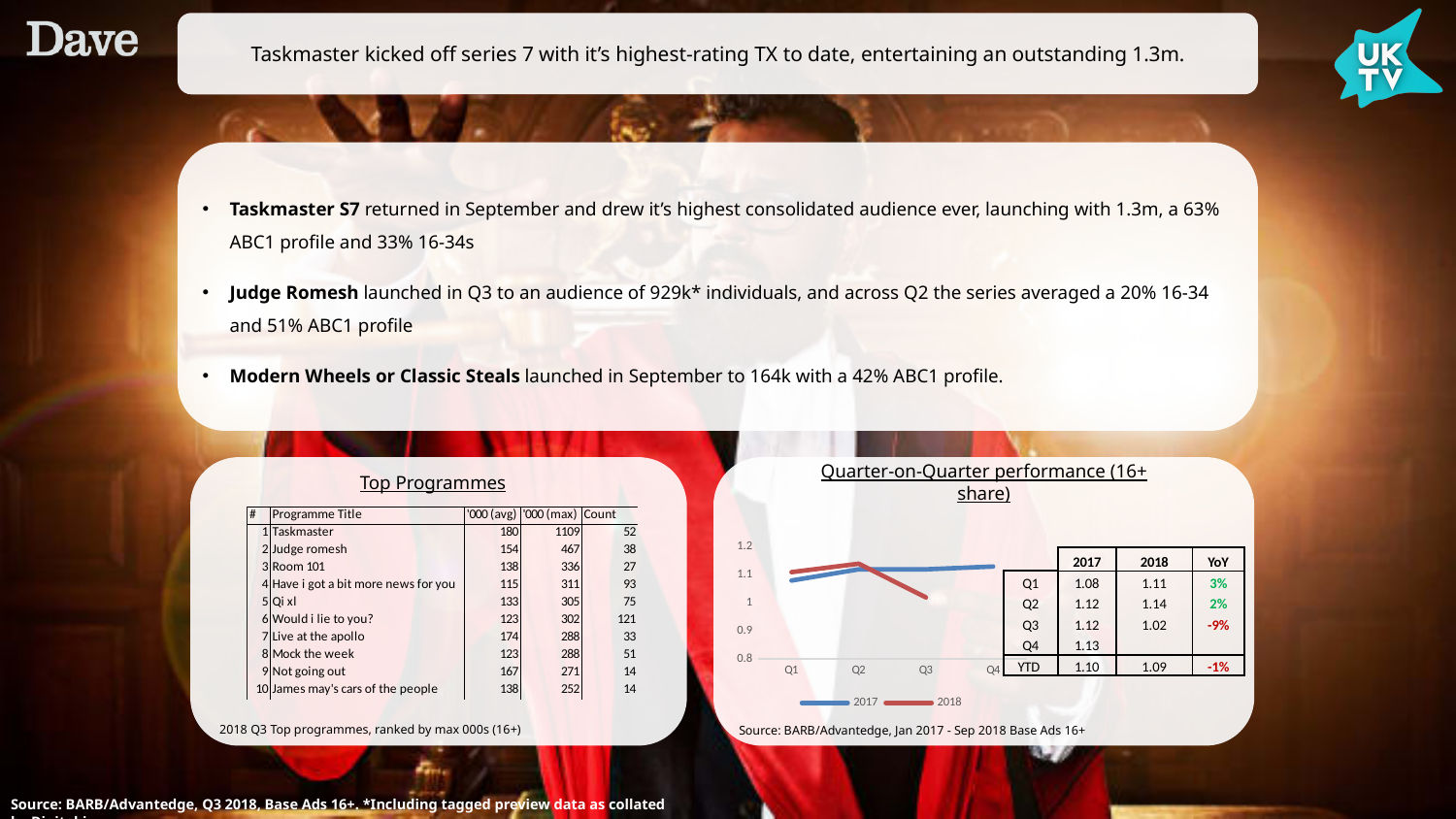
According to the table beside the Quarter-on-Quarter performance chart, what is the 2018 value for Q3? 1.02 In the Quarter-on-Quarter performance chart, which series has the higher value at Q3, 2017 or 2018? 2017 Using the table beside the Quarter-on-Quarter performance chart, what is the difference between the 2018 Q2 value and the 2018 Q3 value? 0.12 According to the table beside the Quarter-on-Quarter performance chart, what is the 2017 value for Q1? 1.08 In the Quarter-on-Quarter performance chart, is the 2018 value for Q3 greater or less than 1.1? less How many series does the legend of the Quarter-on-Quarter performance chart list? 2 In the Quarter-on-Quarter performance chart, at which quarter is the 2018 line at its lowest? Q3 What are the two legend entries of the Quarter-on-Quarter performance chart? 2017 and 2018 In the Quarter-on-Quarter performance chart, does the 2018 line rise or fall from Q2 to Q3? fall How many quarters are shown on the x axis of the Quarter-on-Quarter performance chart? 4 What kind of chart is the Quarter-on-Quarter performance (16+ share) chart? line chart According to the table beside the Quarter-on-Quarter performance chart, what is the YoY change for Q3? -9%